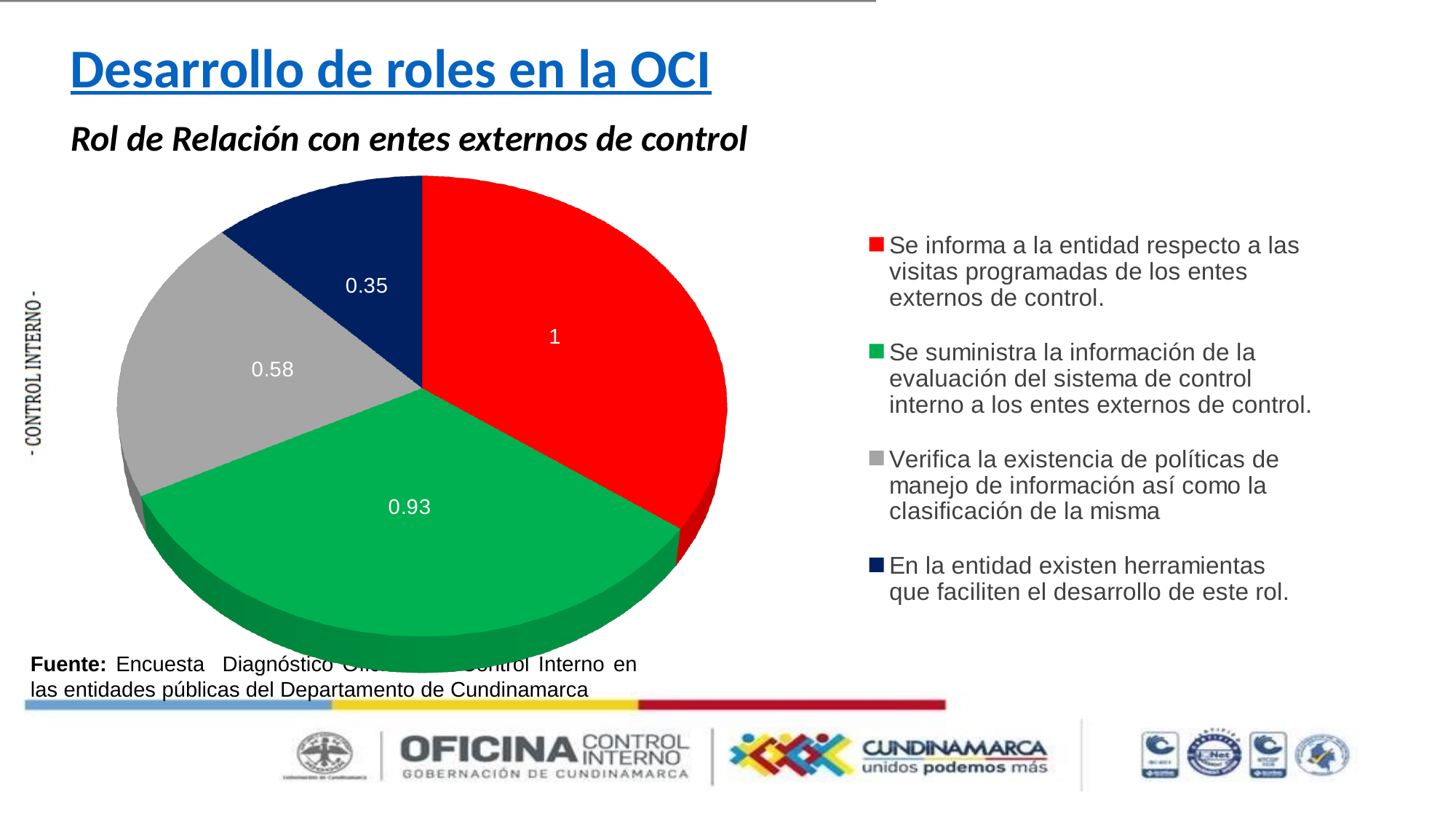
What kind of chart is shown on the slide? pie chart What is the value for "Se informa a la entidad respecto a las visitas programadas de los entes externos de control"? 1 What is the difference between the value for "Verifica la existencia de políticas de manejo de información así como la clasificación de la misma" and the value for "En la entidad existen herramientas que faciliten el desarrollo de este rol"? 0.23 Which is larger: the value for "Se suministra la información de la evaluación del sistema de control interno a los entes externos de control" or the value for "Verifica la existencia de políticas de manejo de información así como la clasificación de la misma"? Se suministra la información de la evaluación del sistema de control interno a los entes externos de control Which category has the highest value in the pie chart? Se informa a la entidad respecto a las visitas programadas de los entes externos de control How many slices does the pie chart have? 4 What colour is the slice with the value 0.35? dark blue Which category has the lowest value in the pie chart? En la entidad existen herramientas que faciliten el desarrollo de este rol What is the difference between the value for "Se informa a la entidad respecto a las visitas programadas de los entes externos de control" and the value for "Se suministra la información de la evaluación del sistema de control interno a los entes externos de control"? 0.07 What is the value for "En la entidad existen herramientas que faciliten el desarrollo de este rol"? 0.35 What is the value for "Se suministra la información de la evaluación del sistema de control interno a los entes externos de control"? 0.93 What is the value for "Verifica la existencia de políticas de manejo de información así como la clasificación de la misma"? 0.58